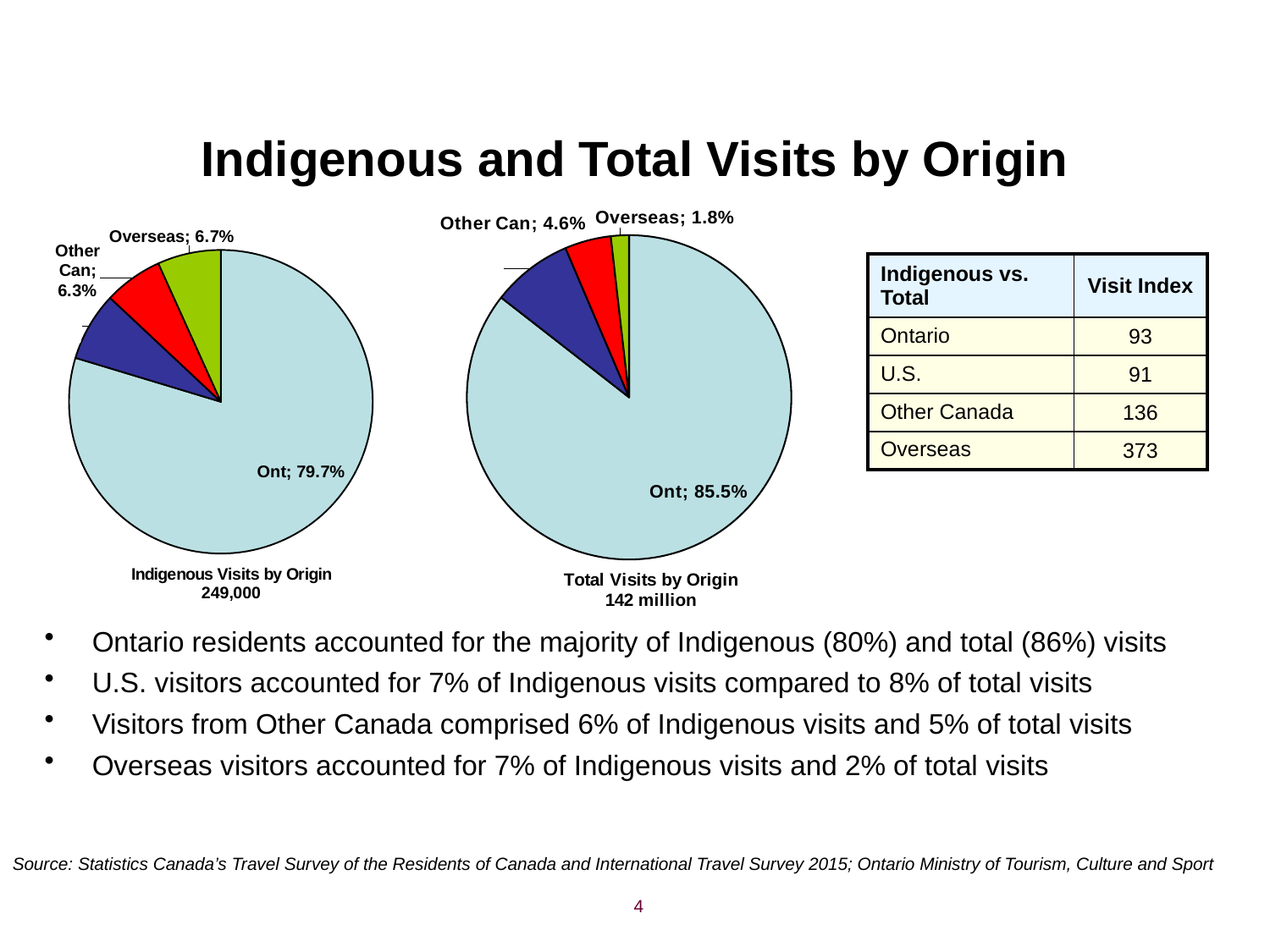
How many slices does the Total Visits by Origin pie chart have? 4 In the Total Visits by Origin pie chart, what share is labelled for Other Can? 4.6% Is the Overseas share larger in the Indigenous Visits by Origin chart or the Total Visits by Origin chart? Indigenous Visits by Origin In the Indigenous Visits by Origin pie chart, what share is labelled for Overseas? 6.7% In the Total Visits by Origin pie chart, what share of visits is labelled for Ont? 85.5% What kind of chart is used for Indigenous Visits by Origin? Pie chart In the Indigenous Visits by Origin pie chart, what share of visits is labelled for Ont? 79.7% What is the difference between the Ont share in the Total Visits by Origin chart and the Ont share in the Indigenous Visits by Origin chart? 5.8 percentage points What total number of visits is shown beneath the Total Visits by Origin pie chart? 142 million In the Total Visits by Origin pie chart, which labelled origin has the smallest slice? Overseas In the Total Visits by Origin pie chart, what share is labelled for Overseas? 1.8% In the Indigenous Visits by Origin pie chart, which labelled origin has the largest slice? Ont